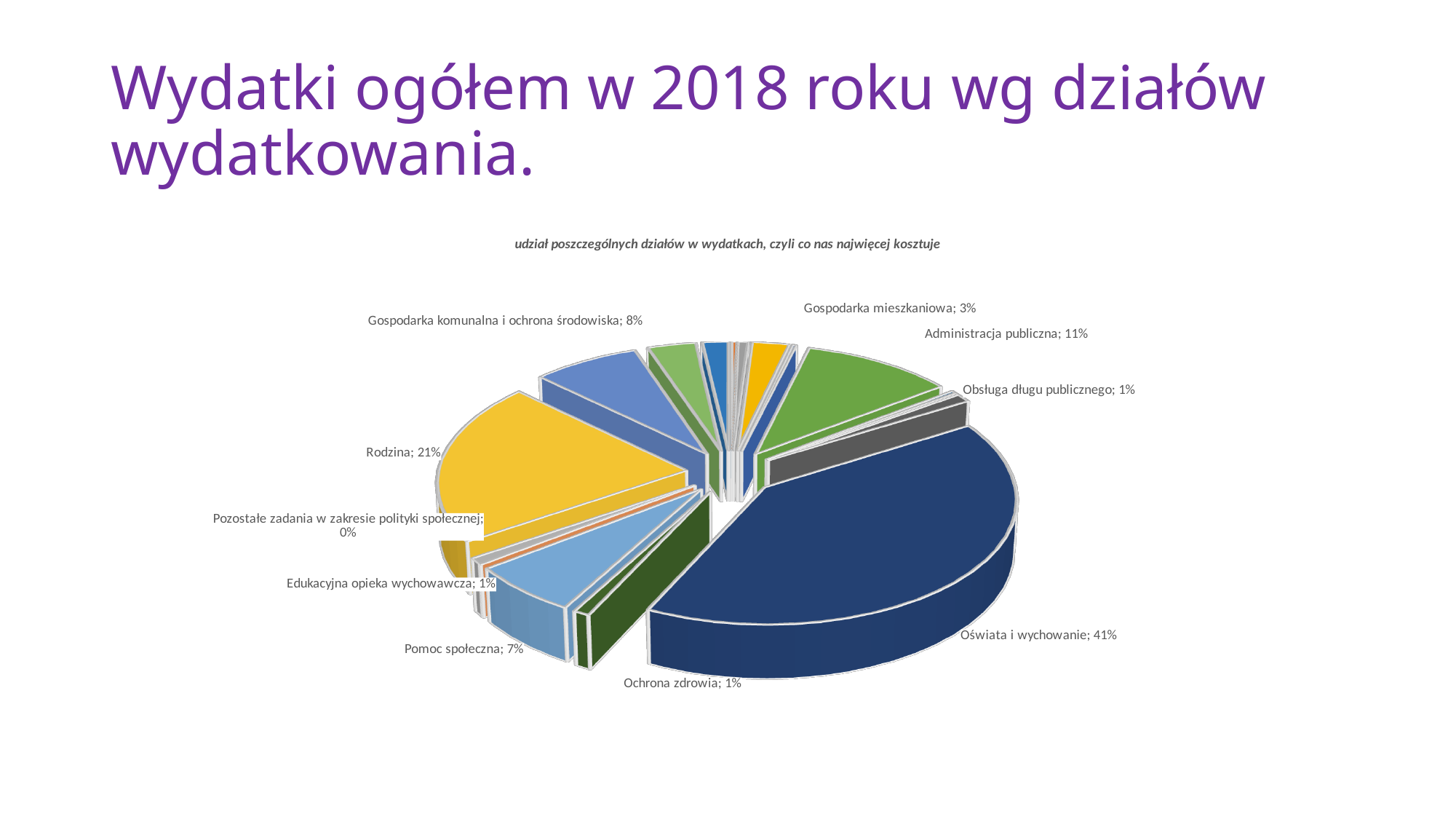
What percentage is shown for Administracja publiczna? 11% What percentage is shown for Gospodarka komunalna i ochrona środowiska? 8% What is the title of the chart? udział poszczególnych działów w wydatkach, czyli co nas najwięcej kosztuje Which labelled category has the smallest share of the pie? Pozostałe zadania w zakresie polityki społecznej What kind of chart is shown on the slide? Pie chart What percentage is shown for Rodzina? 21% What percentage is shown for Gospodarka mieszkaniowa? 3% Which category has the largest share of the pie? Oświata i wychowanie What share of the pie does Oświata i wychowanie have? 41% What percentage is shown for Pomoc społeczna? 7% What is the difference in percentage points between Oświata i wychowanie and Rodzina? 20 Which is larger, the share for Administracja publiczna or the share for Gospodarka komunalna i ochrona środowiska? Administracja publiczna